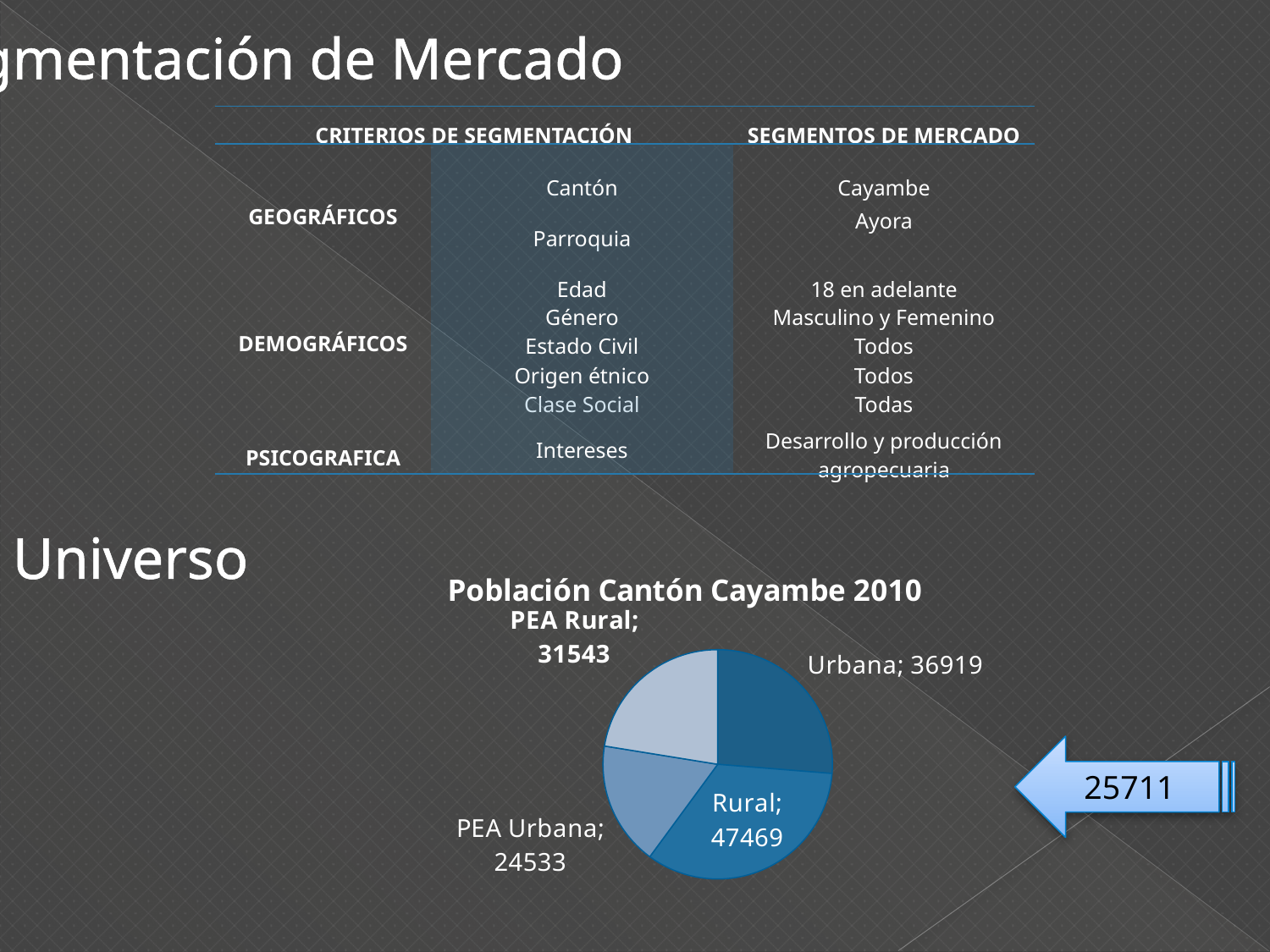
In the pie chart, which is larger: Urbana or PEA Rural? Urbana Which slice of the pie chart has the smallest value? PEA Urbana In the pie chart, what is the value for Rural? 47469 In the pie chart, what is the value for Urbana? 36919 What type of chart is shown under the heading "Universo"? pie chart What is the title of the pie chart? Población Cantón Cayambe 2010 In the pie chart, what is the value for PEA Urbana? 24533 How many slices does the pie chart have? 4 Which slice of the pie chart has the largest value? Rural In the pie chart, what is the difference between the Rural and Urbana values? 10550 In the pie chart, what is the value for PEA Rural? 31543 In the pie chart, what is the difference between the PEA Rural and PEA Urbana values? 7010